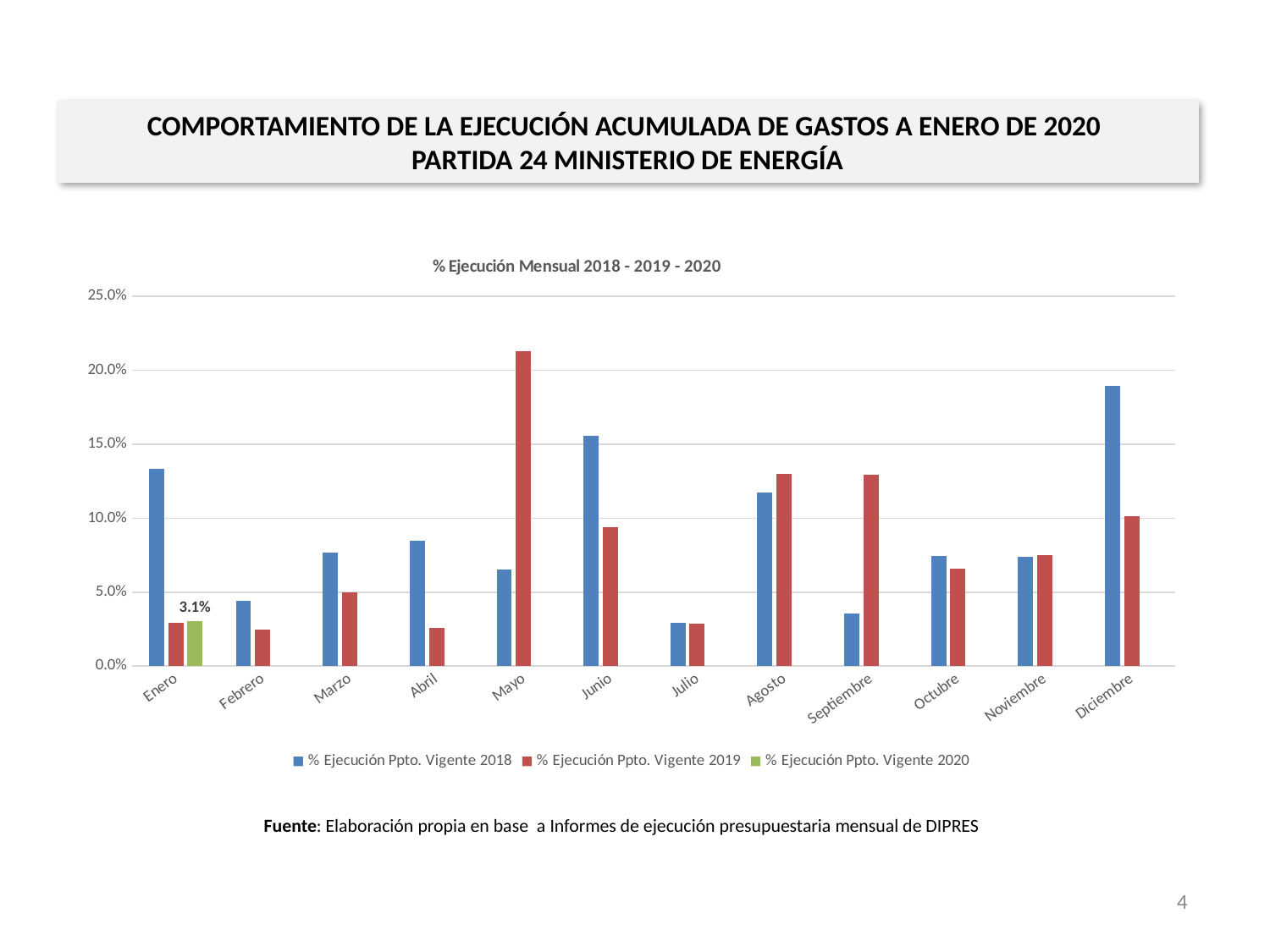
Is the value for % Ejecución Ppto. Vigente 2019 in Febrero greater or less than 5.0%? less What is the title of the chart? % Ejecución Mensual 2018 - 2019 - 2020 How many series does the legend list? 3 In Septiembre, which series has the larger value: % Ejecución Ppto. Vigente 2018 or % Ejecución Ppto. Vigente 2019? % Ejecución Ppto. Vigente 2019 Is the value for % Ejecución Ppto. Vigente 2019 in Mayo greater or less than 20.0%? greater How many months are shown on the x axis? 12 Which month has the highest value for % Ejecución Ppto. Vigente 2019? Mayo What kind of chart is shown on the slide? Bar chart Which month has the highest value for % Ejecución Ppto. Vigente 2018? Diciembre In Enero, which series has the larger value: % Ejecución Ppto. Vigente 2018 or % Ejecución Ppto. Vigente 2019? % Ejecución Ppto. Vigente 2018 Is the value for % Ejecución Ppto. Vigente 2018 in Diciembre greater or less than 15.0%? greater What is the value for % Ejecución Ppto. Vigente 2020 in Enero? 3.1%